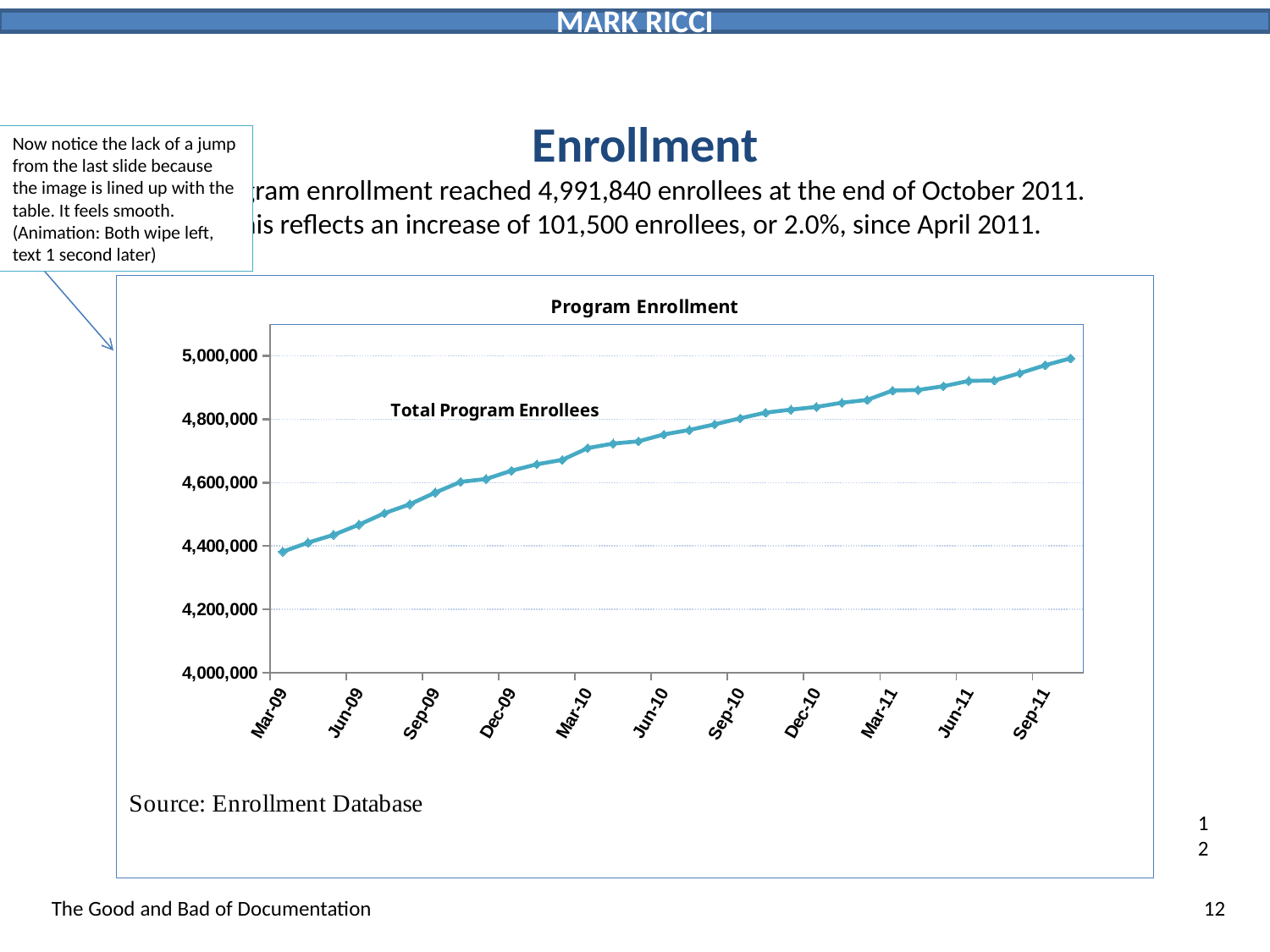
What kind of chart is shown on the slide? line chart Is the value for Jun-10 greater or less than 4,800,000? less Which is larger, the value for Sep-11 or the value for Mar-09? Sep-11 How many month labels are shown on the x axis? 11 Do the values rise or fall from Mar-09 to Sep-11? rise What is the title of the chart? Program Enrollment Is the value for Mar-09 greater or less than 4,400,000? less Is the value for Sep-11 greater or less than 4,800,000? greater Which labelled month on the x axis has the lowest value? Mar-09 How many data series does the chart plot? 1 What is the name of the series plotted in the chart? Total Program Enrollees